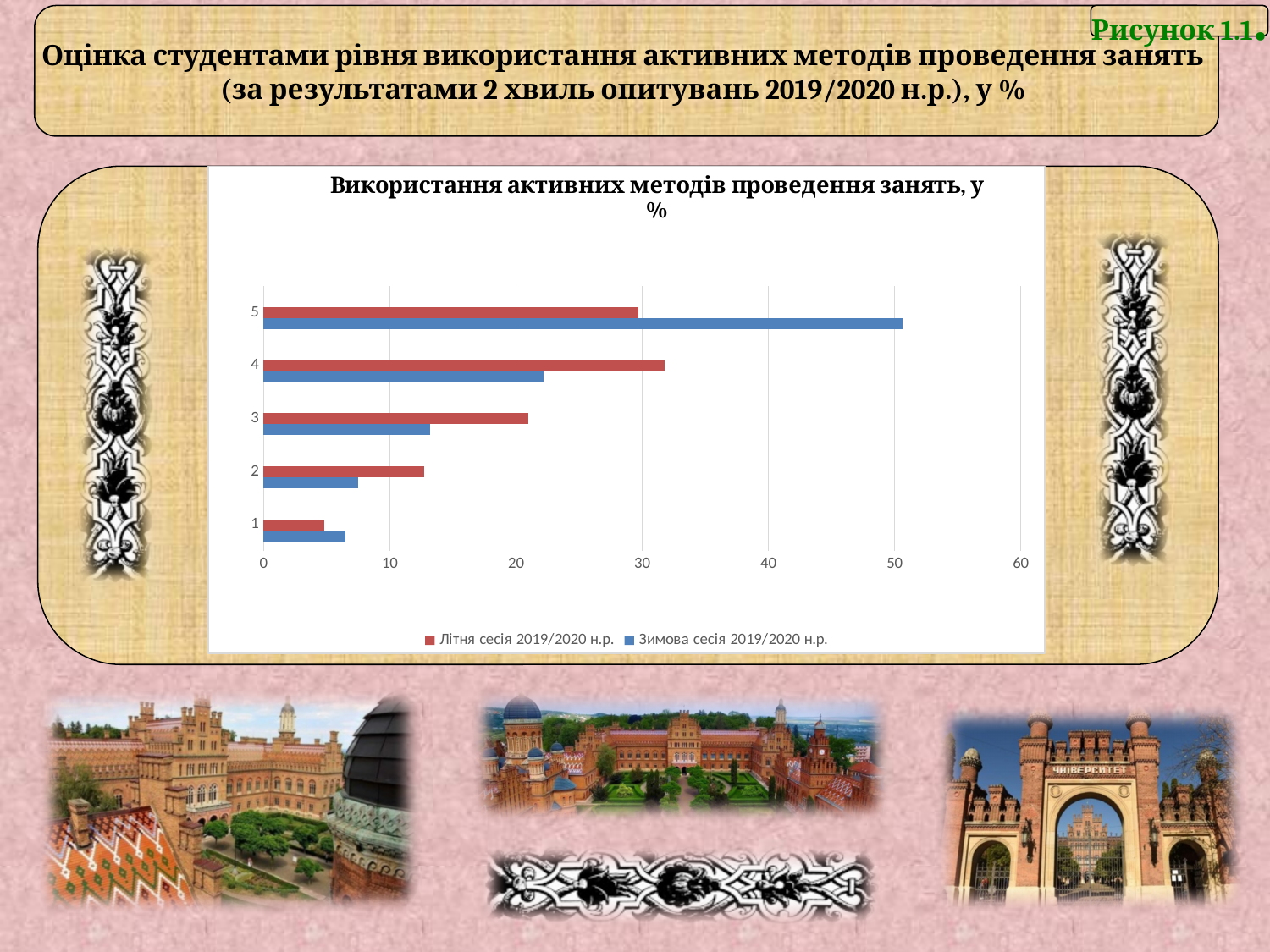
For category 4, which series has the larger value: Літня сесія 2019/2020 н.р. or Зимова сесія 2019/2020 н.р.? Літня сесія 2019/2020 н.р. Which category has the lowest value for the series Літня сесія 2019/2020 н.р.? 1 Which category has the highest value for the series Зимова сесія 2019/2020 н.р.? 5 Which category has the highest value for the series Літня сесія 2019/2020 н.р.? 4 Which category has the lowest value for the series Зимова сесія 2019/2020 н.р.? 1 For category 5, which series has the larger value: Літня сесія 2019/2020 н.р. or Зимова сесія 2019/2020 н.р.? Зимова сесія 2019/2020 н.р. What kind of chart is shown on the slide? bar chart What is the title of the chart? Використання активних методів проведення занять, у % How many series does the chart legend list? 2 Is the value for category 2 in the series Зимова сесія 2019/2020 н.р. greater or less than 10? less How many categories are shown on the vertical axis of the chart? 5 Is the value for category 5 in the series Зимова сесія 2019/2020 н.р. greater or less than 40? greater